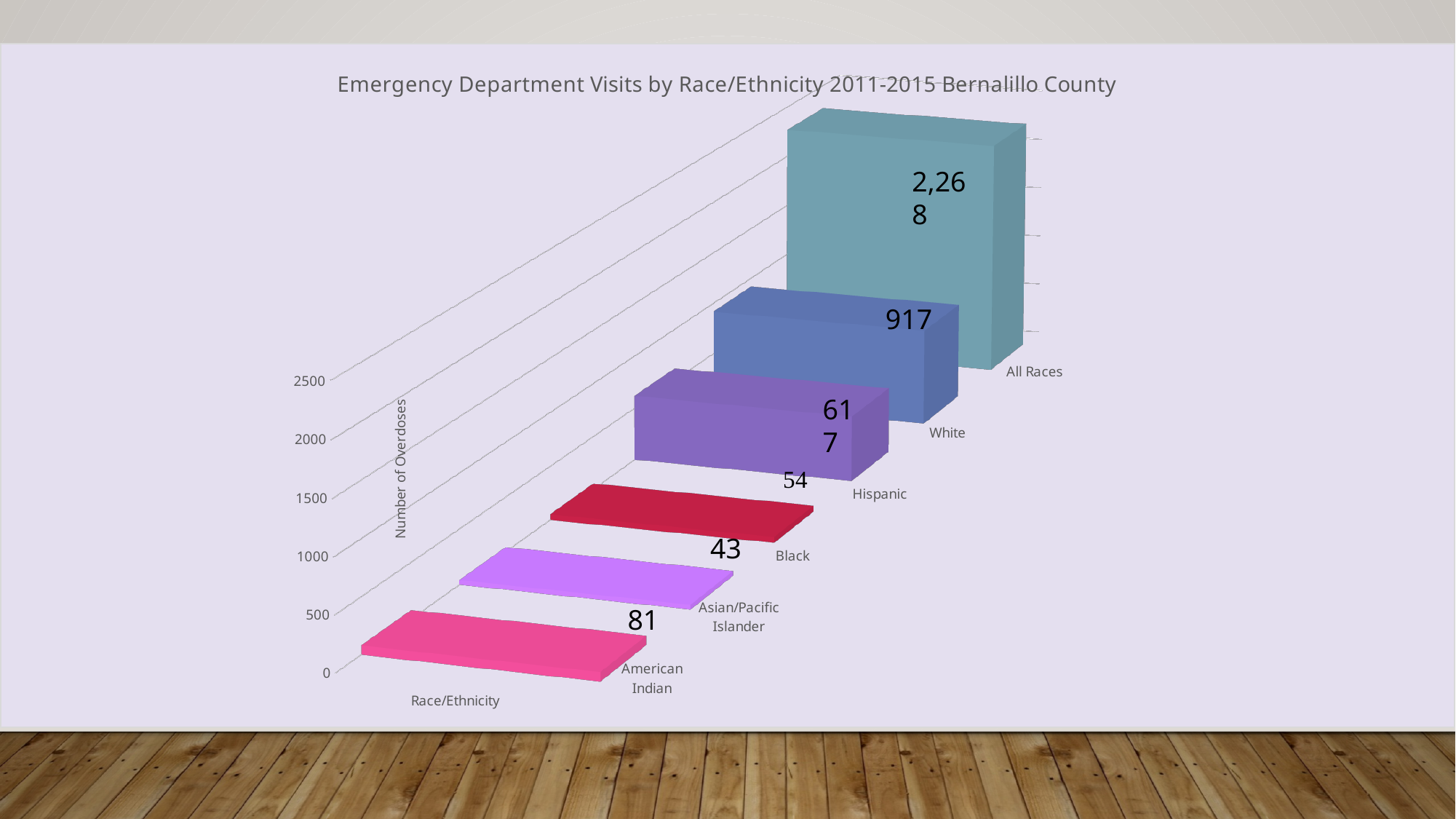
What is the value for American Indian? 81 What is the value for Asian/Pacific Islander? 43 Which is larger, the value for Black or the value for American Indian? American Indian Which category has the highest value? All Races What is the title of the vertical axis? Number of Overdoses Which category has the lowest value? Asian/Pacific Islander What is the value for Black? 54 What is the value for White? 917 What is the value for Hispanic? 617 How many categories are shown on the chart? 6 What kind of chart is shown on the slide? Bar chart What is the difference between the values for White and Hispanic? 300